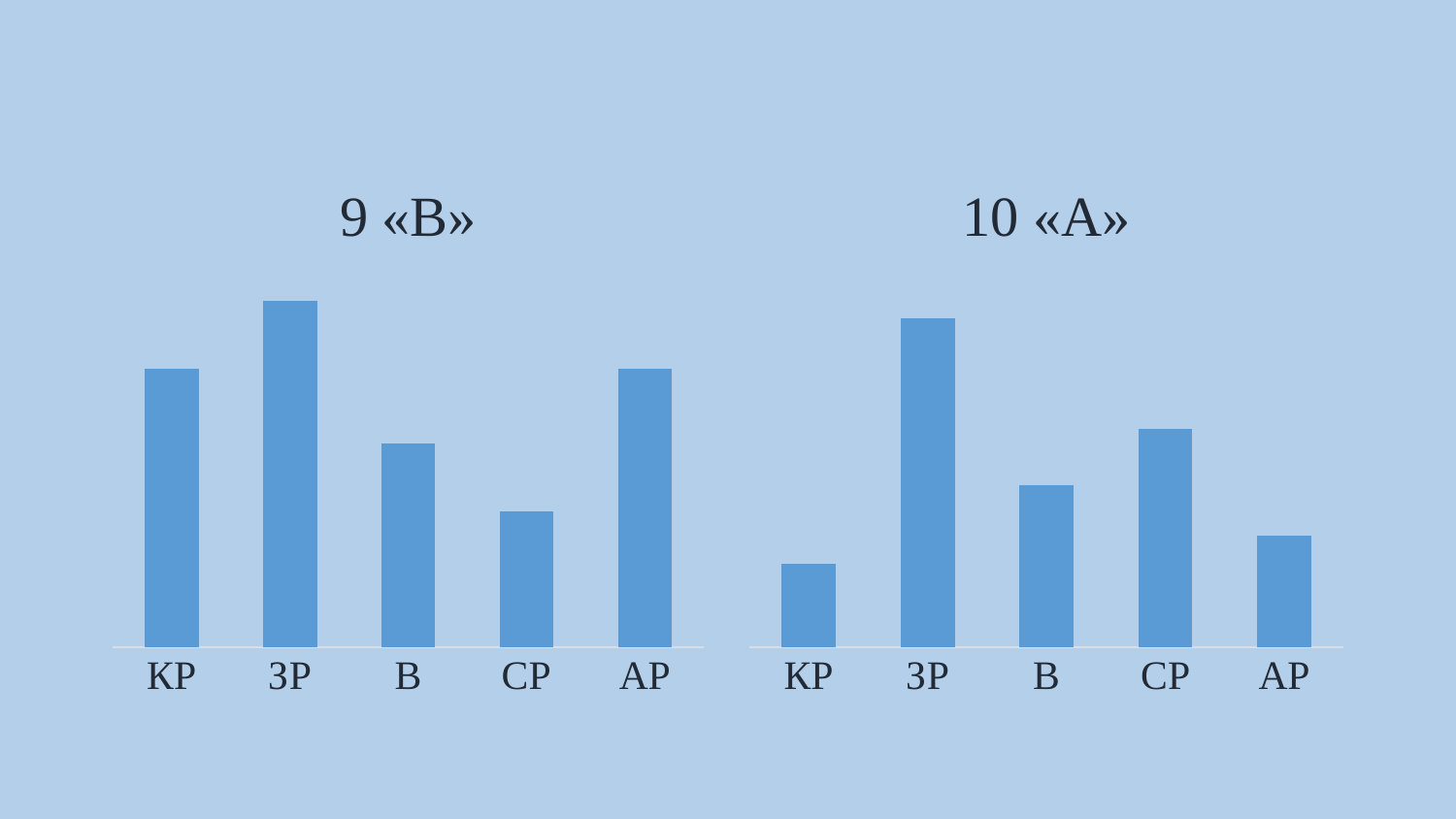
In the chart titled 9 «В», which is larger, the bar for ЗР or the bar for КР? ЗР In the chart titled 9 «В», which category has the highest bar? ЗР In the chart titled 9 «В», which category has the lowest bar? СР In the chart titled 10 «А», which is larger, the bar for СР or the bar for В? СР How many categories are shown in the chart titled 9 «В»? 5 In the chart titled 9 «В», which is larger, the bar for В or the bar for СР? В What is the title of the chart on the left side of the slide? 9 «В» In the chart titled 10 «А», which category has the highest bar? ЗР How many categories are shown in the chart titled 10 «А»? 5 In the chart titled 10 «А», which category has the lowest bar? КР What type of chart is the chart titled 10 «А»? Bar chart